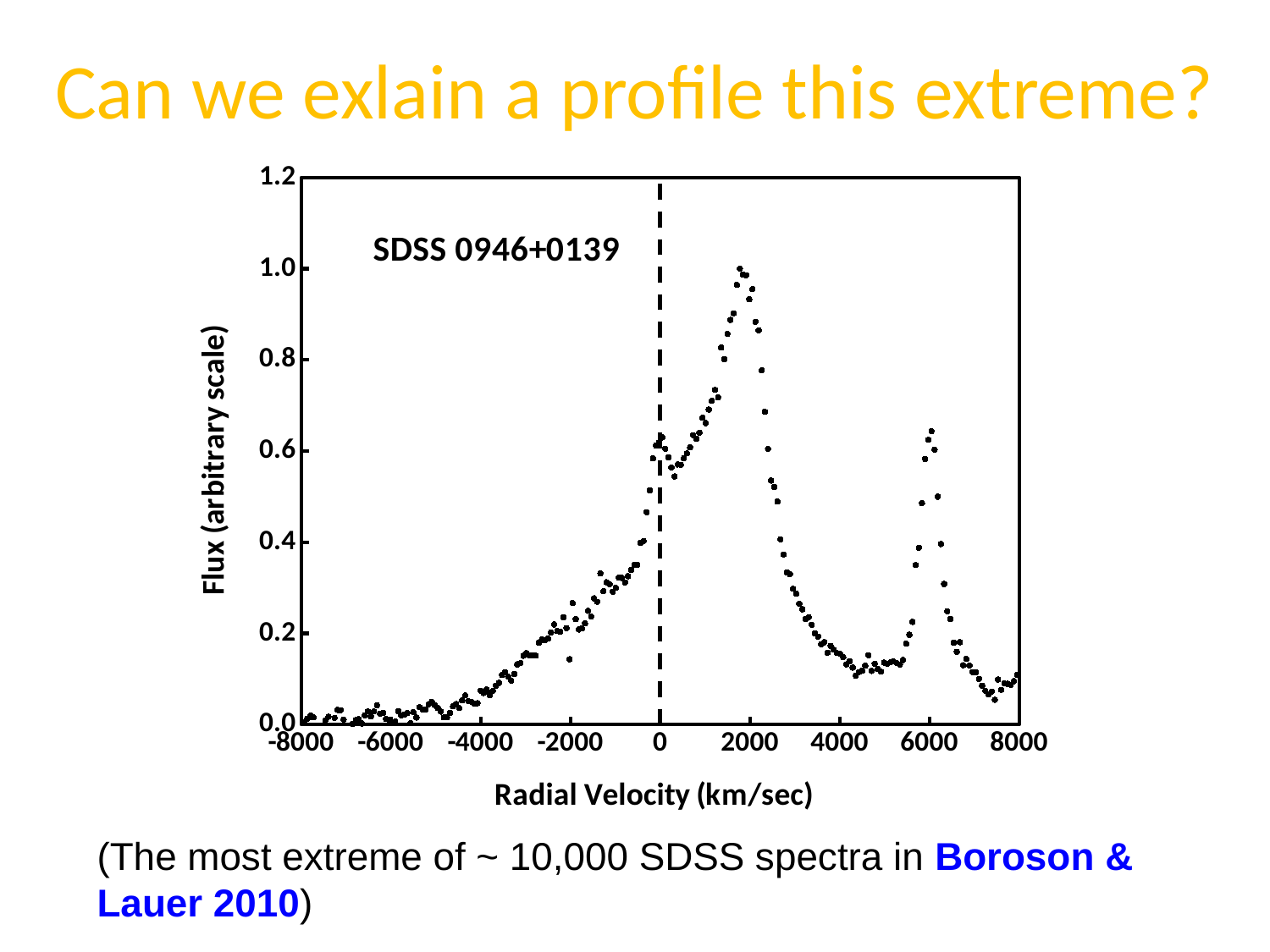
At what radial velocity is the vertical dashed line drawn? 0 Is the flux at the secondary peak near 6000 km/sec greater or less than 0.8? less Is the flux at a radial velocity of 4000 km/sec greater or less than 0.4? less Is the peak flux near a radial velocity of 2000 km/sec greater or less than 0.8? greater What kind of chart is shown on the slide? scatter plot What is the label of the x axis? Radial Velocity (km/sec) Does the flux generally rise or fall as radial velocity increases from -8000 to 0 km/sec? rise Does the flux rise or fall as radial velocity increases from 2000 to 4000 km/sec? fall Near which x-axis tick value does the flux reach its maximum? 2000 Which peak is higher: the one near 2000 km/sec or the one near 6000 km/sec? the one near 2000 km/sec